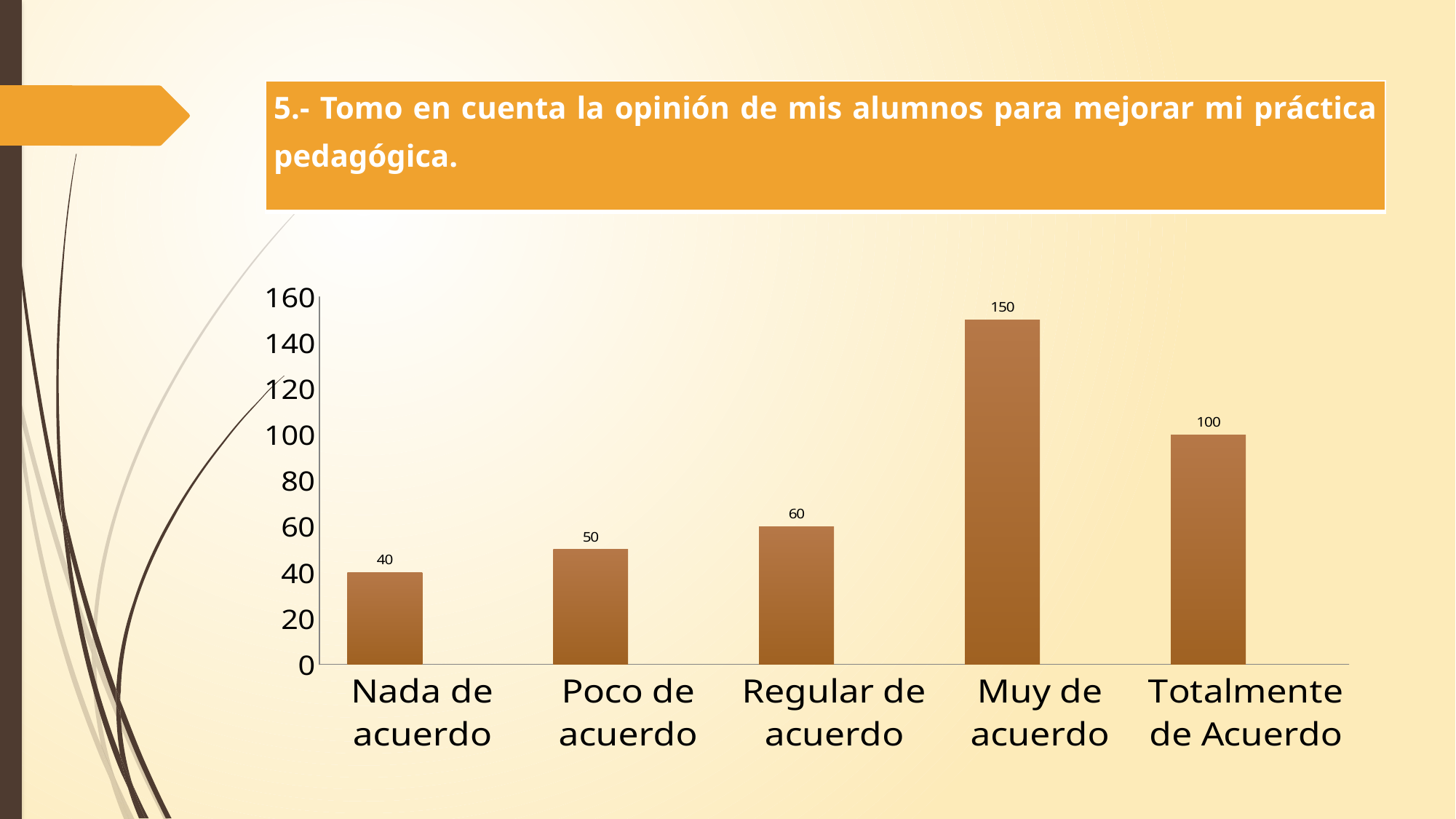
Which is larger, the value for "Poco de acuerdo" or the value for "Regular de acuerdo"? Regular de acuerdo What is the value for "Muy de acuerdo"? 150 Is the value for "Muy de acuerdo" greater or less than 140? greater What is the difference between the values for "Muy de acuerdo" and "Totalmente de Acuerdo"? 50 What is the value for "Totalmente de Acuerdo"? 100 What is the difference between the values for "Regular de acuerdo" and "Poco de acuerdo"? 10 What kind of chart is shown on the slide? Bar chart Which category has the lowest value? Nada de acuerdo How many categories are shown on the x axis? 5 What is the highest value shown on the vertical axis? 160 What is the value for "Nada de acuerdo"? 40 Which category has the highest value? Muy de acuerdo